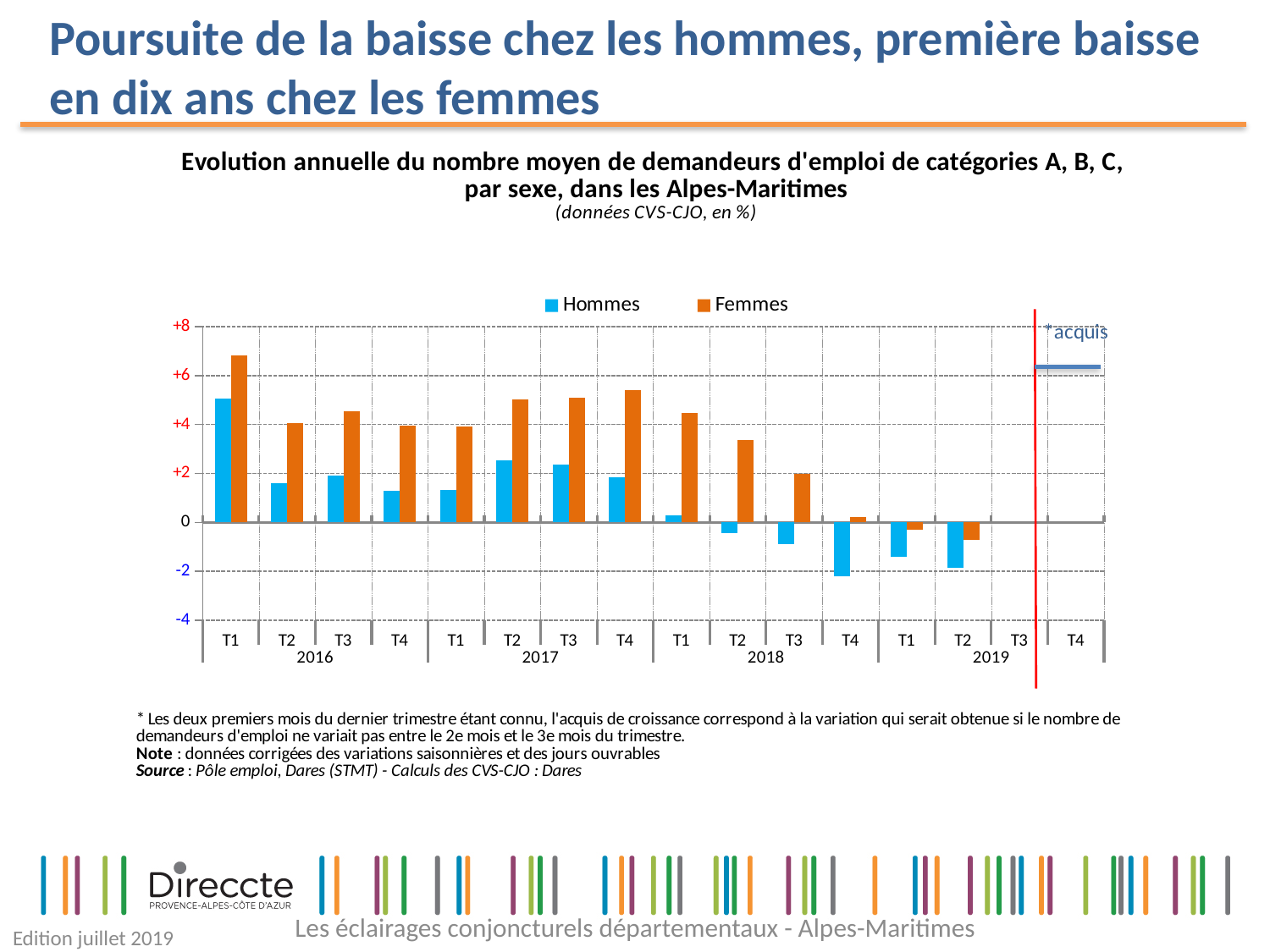
What kind of chart is shown on the slide? bar chart How many series does the legend list? 2 Is the Femmes value for T3 2018 greater or less than +4? less In which quarter is the Femmes value highest? T1 2016 Is the Hommes value for T4 2018 greater or less than 0? less Is the Femmes value for T1 2016 greater or less than +6? greater In which quarter is the Hommes value highest? T1 2016 In T4 2017, which is larger, the Hommes value or the Femmes value? Femmes What are the two series named in the legend? Hommes and Femmes Do the Hommes values rise or fall from T1 2018 to T4 2018? fall In which quarter is the Hommes value lowest? T4 2018